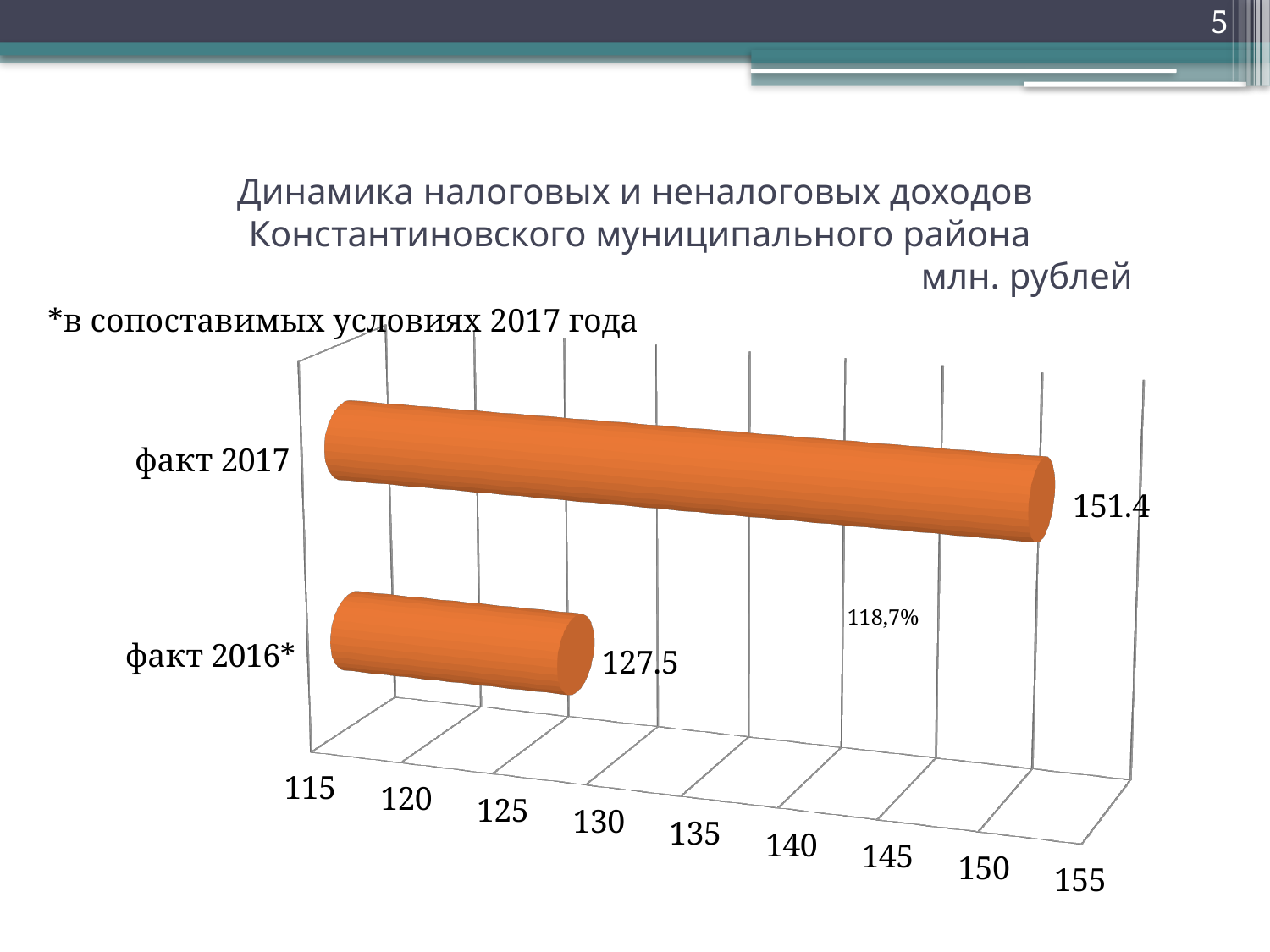
What is the value for факт 2017? 151.4 What is the value for факт 2016*? 127.5 What is the difference between the values for факт 2017 and факт 2016*? 23.9 Which category has the lowest value? факт 2016* Which category has the highest value? факт 2017 What percentage is printed on the chart between the two bars? 118,7% What kind of chart is shown on the slide? bar chart Is the value for факт 2017 greater or less than 150? greater What unit of measurement is stated for the chart? млн. рублей Which is larger, the value for факт 2017 or the value for факт 2016*? факт 2017 How many categories are shown in the chart? 2 Is the value for факт 2016* greater or less than 130? less